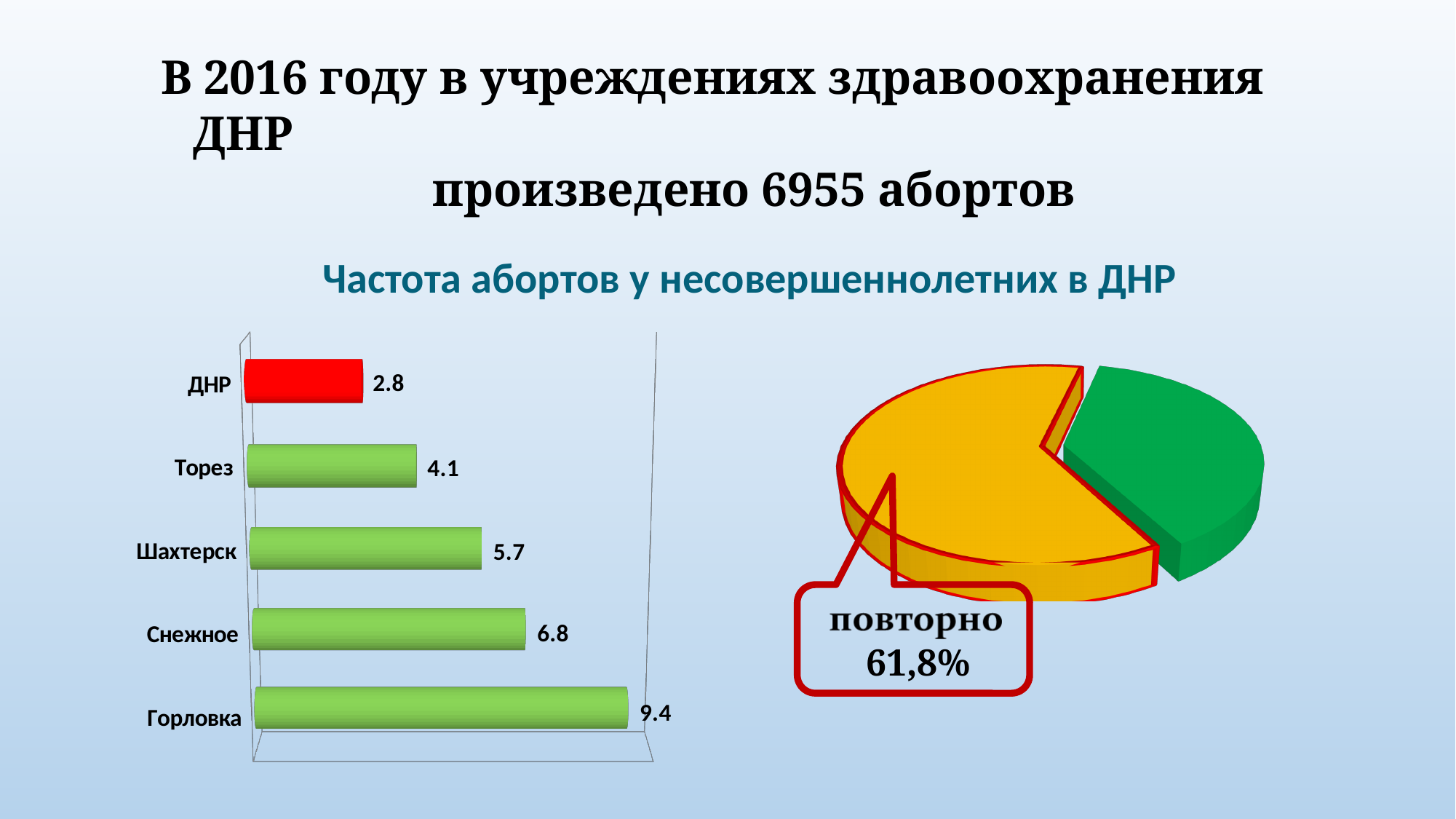
On the pie chart on the right, what share is labelled "повторно"? 61,8% On the bar chart on the left, which category has the lowest value? ДНР On the bar chart on the left, how many categories are shown? 5 On the bar chart on the left, what is the difference between the values for Горловка and Торез? 5.3 On the bar chart on the left, what is the value for Горловка? 9.4 On the bar chart on the left, which bar is coloured red rather than green? ДНР On the bar chart on the left, which is larger, the value for Снежное or the value for Торез? Снежное On the bar chart on the left, what is the value for ДНР? 2.8 On the bar chart on the left, which category has the highest value? Горловка What kind of chart is the chart on the left of the slide? bar chart On the bar chart on the left, what is the value for Шахтерск? 5.7 On the bar chart on the left, what is the difference between the values for Снежное and Шахтерск? 1.1